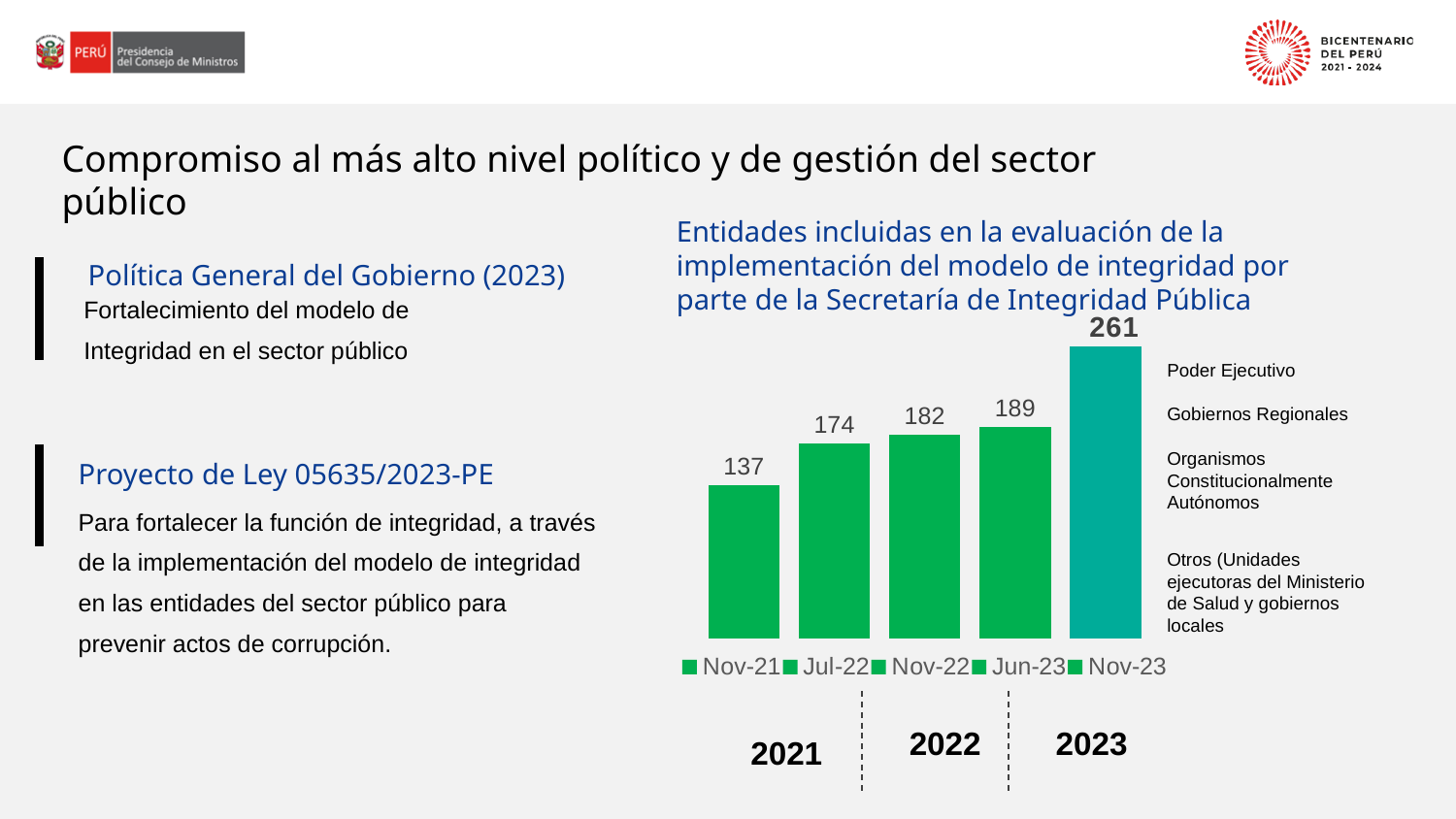
Which is larger, the value for Nov-22 or the value for Jul-22? Nov-22 What kind of chart is shown on the slide? Bar chart Which period has the lowest value in the chart? Nov-21 What is the difference between the values for Jul-22 and Nov-21? 37 What value is shown for Nov-22 in the chart? 182 What value is shown for Nov-21 in the chart? 137 Which period has the highest value in the chart? Nov-23 What value is shown for Jul-22 in the chart? 174 How many bars are plotted in the chart? 5 What value is shown for Jun-23 in the chart? 189 What is the difference between the values for Nov-23 and Jun-23? 72 What value is shown for Nov-23 in the chart? 261